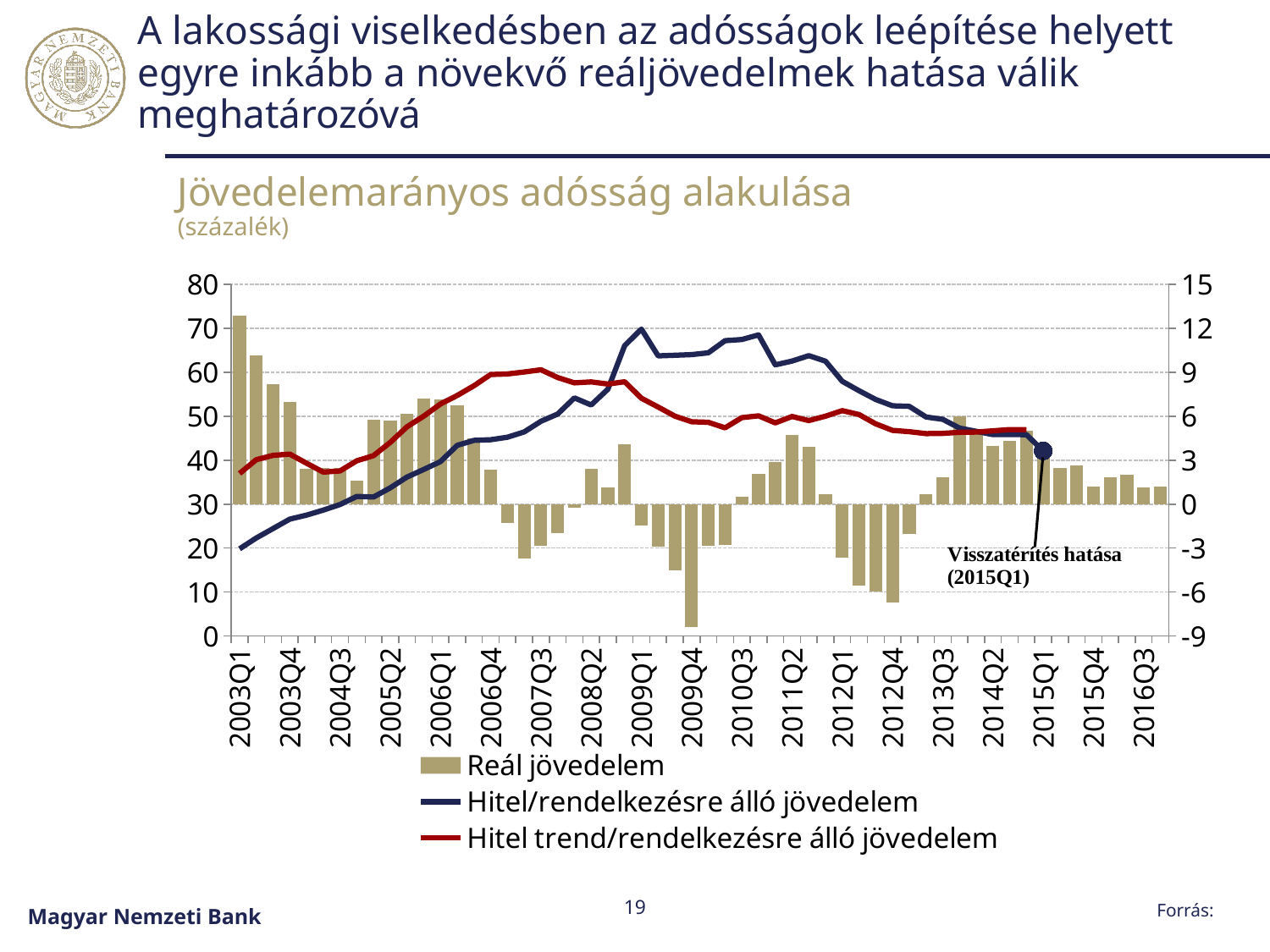
What does the annotation with the arrow pointing to the 2015Q1 point say? Visszatérítés hatása (2015Q1) Is the value of the Hitel/rendelkezésre álló jövedelem line at 2009Q1 greater or less than 60 on the left axis? greater Is the value of the Hitel/rendelkezésre álló jövedelem line at 2003Q1 greater or less than 30 on the left axis? less At 2003Q1, which line is higher: Hitel/rendelkezésre álló jövedelem or Hitel trend/rendelkezésre álló jövedelem? Hitel trend/rendelkezésre álló jövedelem At 2009Q1, which line is higher: Hitel/rendelkezésre álló jövedelem or Hitel trend/rendelkezésre álló jövedelem? Hitel/rendelkezésre álló jövedelem What kind of chart is shown on the slide? A combined bar and line chart What is the title of the chart? Jövedelemarányos adósság alakulása Is the Reál jövedelem bar at 2009Q4 greater or less than 0 on the right axis? less How many series does the legend list? 3 Does the Hitel/rendelkezésre álló jövedelem line rise or fall between 2003Q1 and 2009Q1? rise